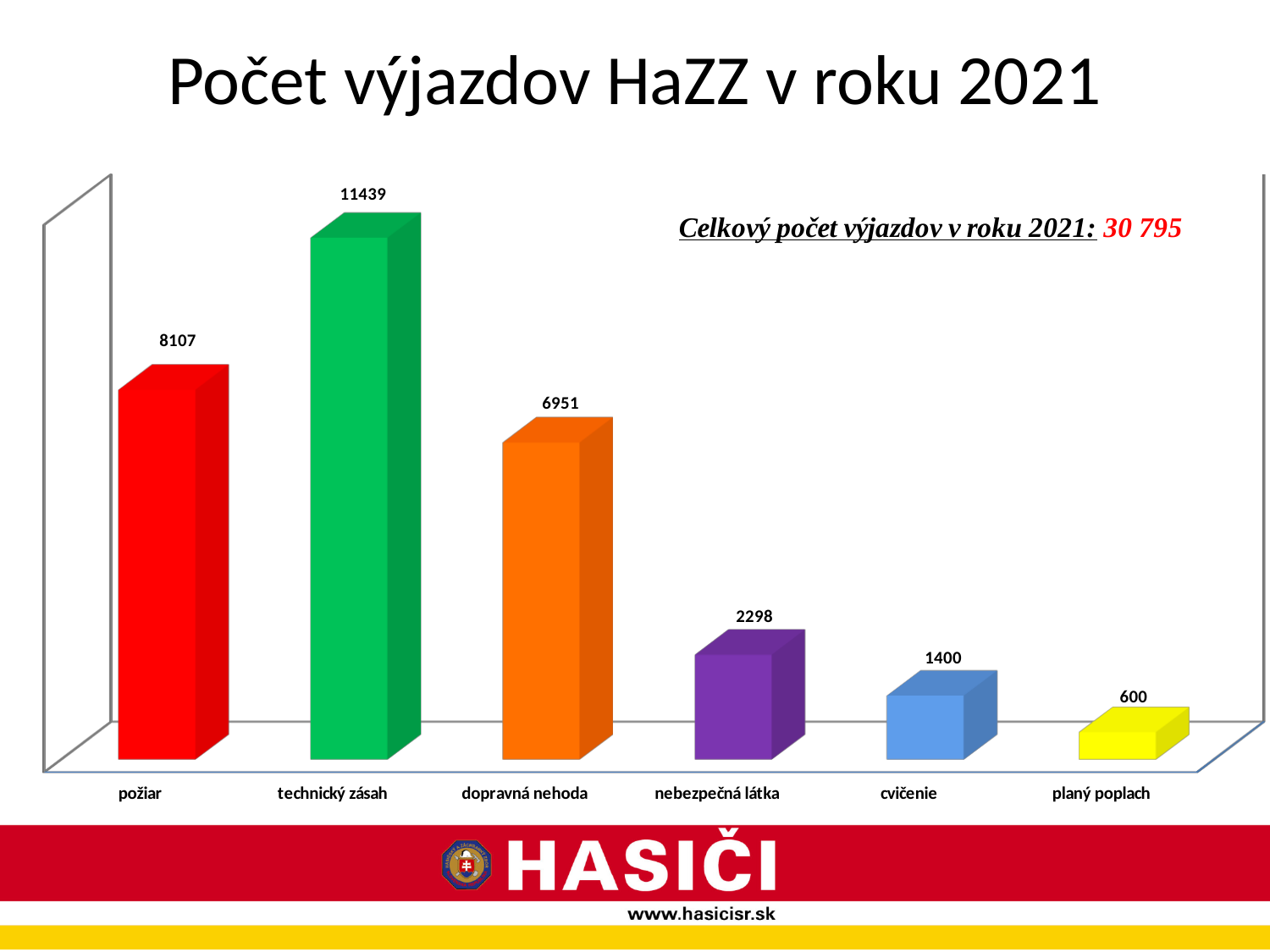
How many categories are shown in the chart? 6 What is the value for cvičenie? 1400 Which category has the highest value? technický zásah What is the title of the slide? Počet výjazdov HaZZ v roku 2021 What is the value for technický zásah? 11439 What is the value for dopravná nehoda? 6951 Which category has the lowest value? planý poplach What kind of chart is shown on the slide? bar chart What is the value for planý poplach? 600 What is the difference between the values for nebezpečná látka and cvičenie? 898 What is the difference between the values for technický zásah and požiar? 3332 Which is larger, the value for požiar or the value for dopravná nehoda? požiar